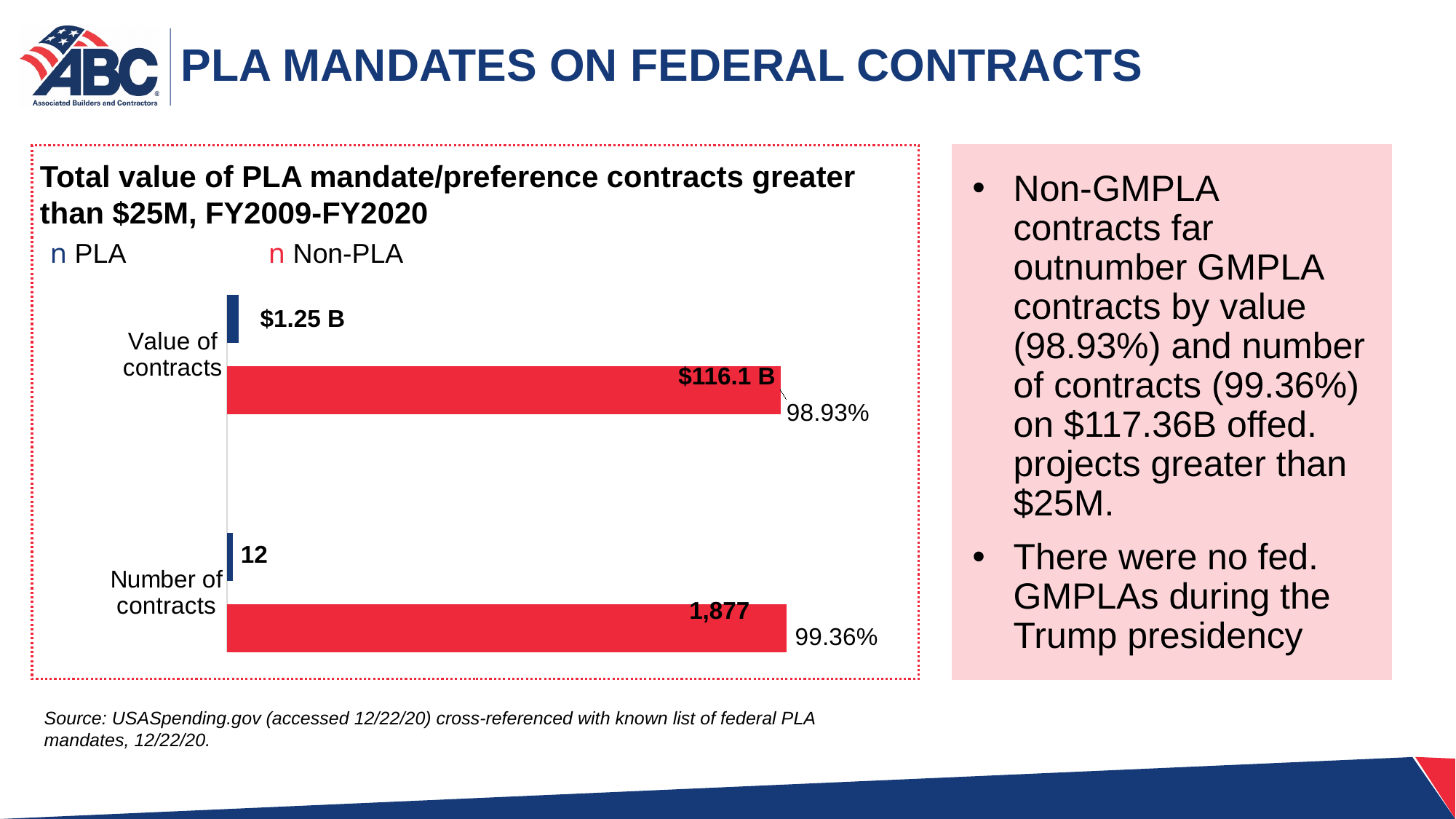
What is the value of PLA contracts shown in the chart? $1.25 B How many series does the chart legend list? 2 What type of chart is shown on the slide? Bar chart How many categories are shown on the chart's vertical axis? 2 Which series has the larger number of contracts, PLA or Non-PLA? Non-PLA How many PLA contracts are shown in the chart? 12 What percentage label is shown next to the Non-PLA bar for number of contracts? 99.36% What percentage label is shown next to the Non-PLA bar for value of contracts? 98.93% How many Non-PLA contracts are shown in the chart? 1,877 What is the value of Non-PLA contracts shown in the chart? $116.1 B What is the difference between the number of Non-PLA contracts and the number of PLA contracts? 1,865 What is the difference between the value of Non-PLA contracts and the value of PLA contracts? $114.85 B